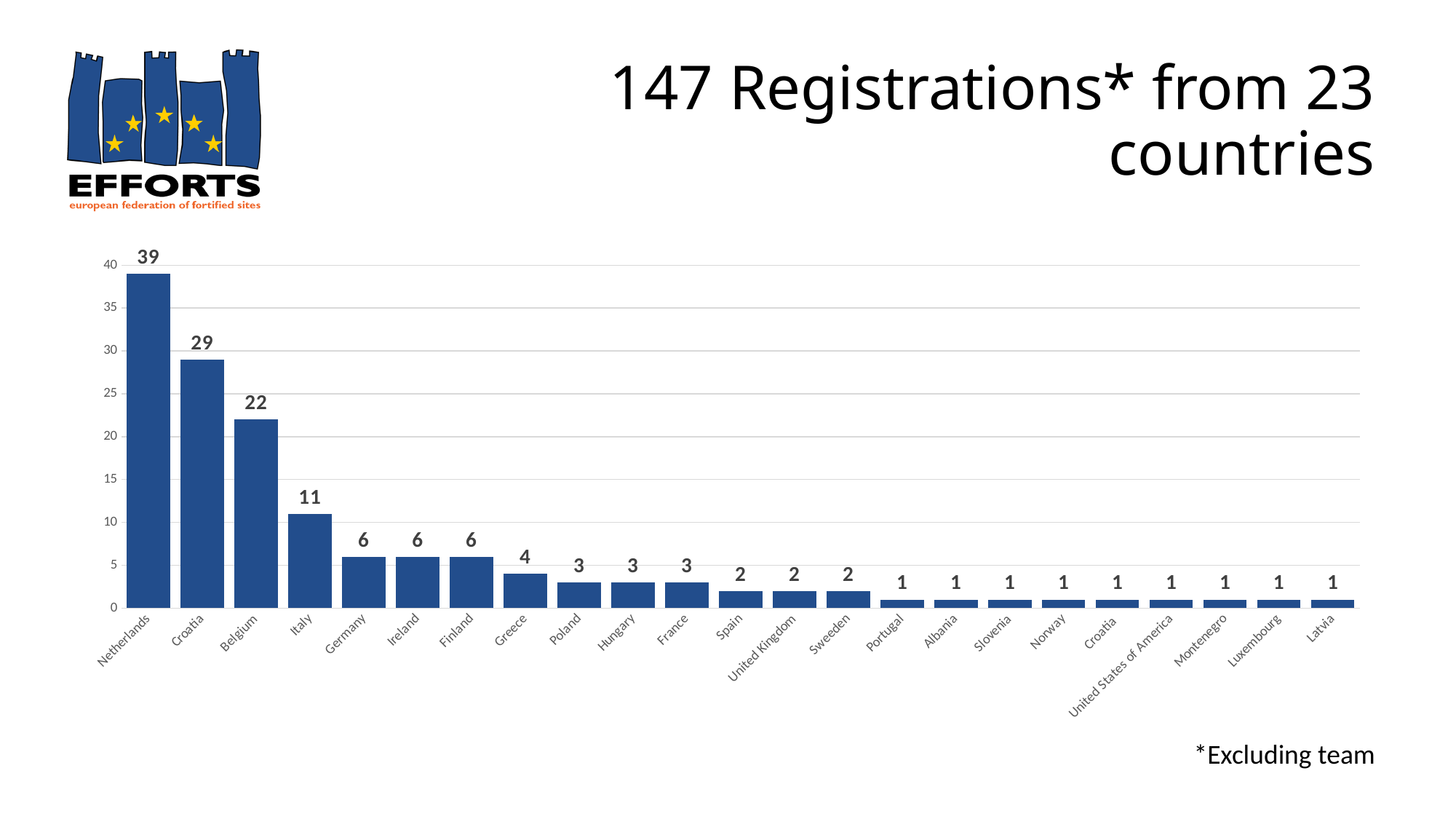
Which country has the highest number of registrations? Netherlands How many countries (bars) are shown in the chart? 23 What is the value for Belgium? 22 What is the value for Italy? 11 What type of chart is shown on the slide? bar chart What is the value for Greece? 4 What is the title of the slide? 147 Registrations* from 23 countries What is the difference between the values for Italy and Germany? 5 What is the difference between the values for the Netherlands and Belgium? 17 How many registrations does the chart show for the Netherlands? 39 Do the values generally rise or fall from left to right along the x axis? fall Which has a larger value, Poland or Spain? Poland